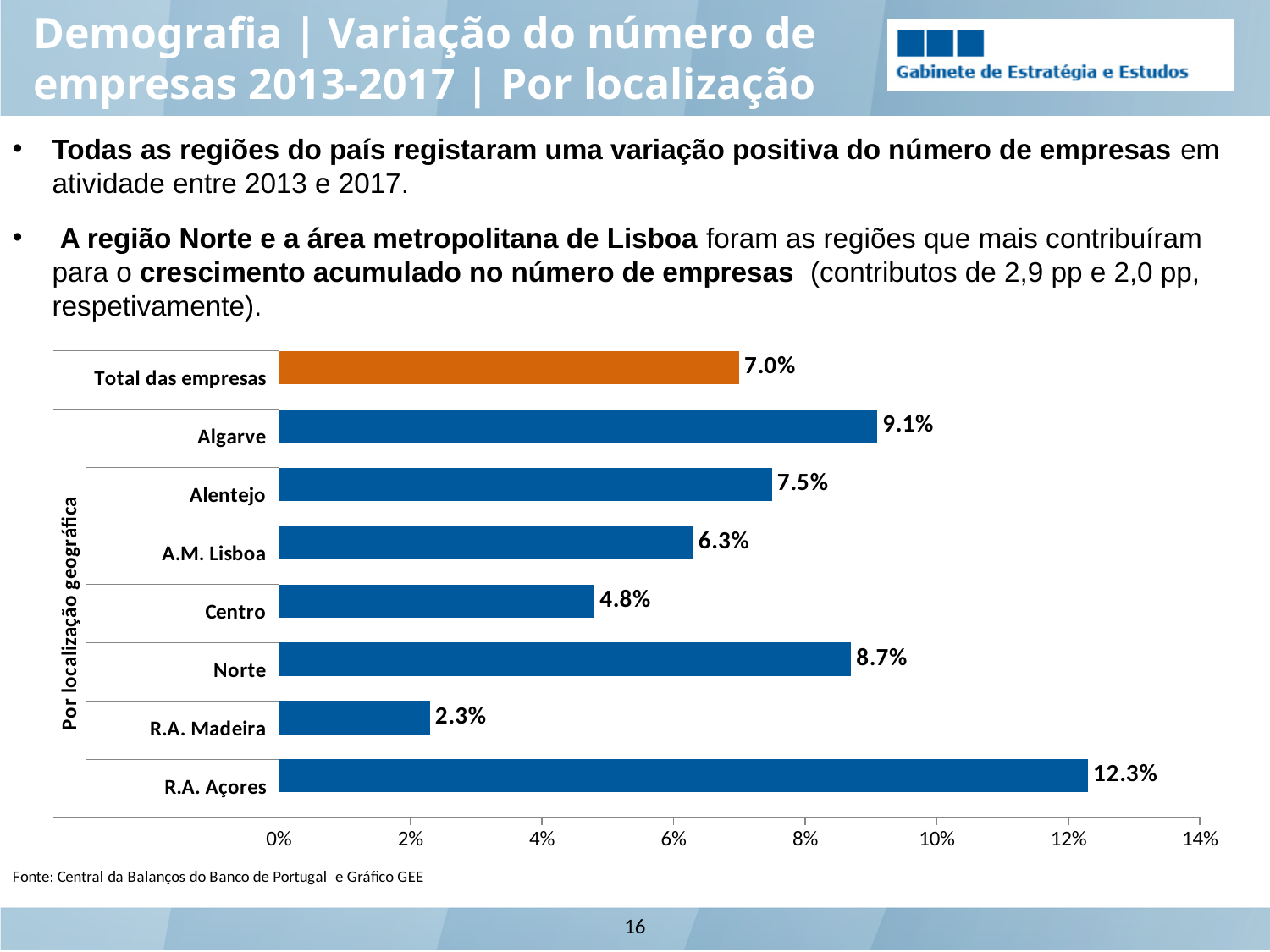
Is the value for Norte greater or less than 8%? greater What is the difference between the values for Algarve and Norte? 0.4% What is the value for Total das empresas? 7.0% Which region has the lowest value? R.A. Madeira How many bars are shown in the chart? 8 What is the value for R.A. Açores? 12.3% Which region has the highest value? R.A. Açores What is the value for Centro? 4.8% Which is larger, the value for Alentejo or the value for A.M. Lisboa? Alentejo What kind of chart is shown on the slide? bar chart What is the difference between the values for R.A. Açores and R.A. Madeira? 10.0% Which bar is shown in a different colour (orange) from the others? Total das empresas